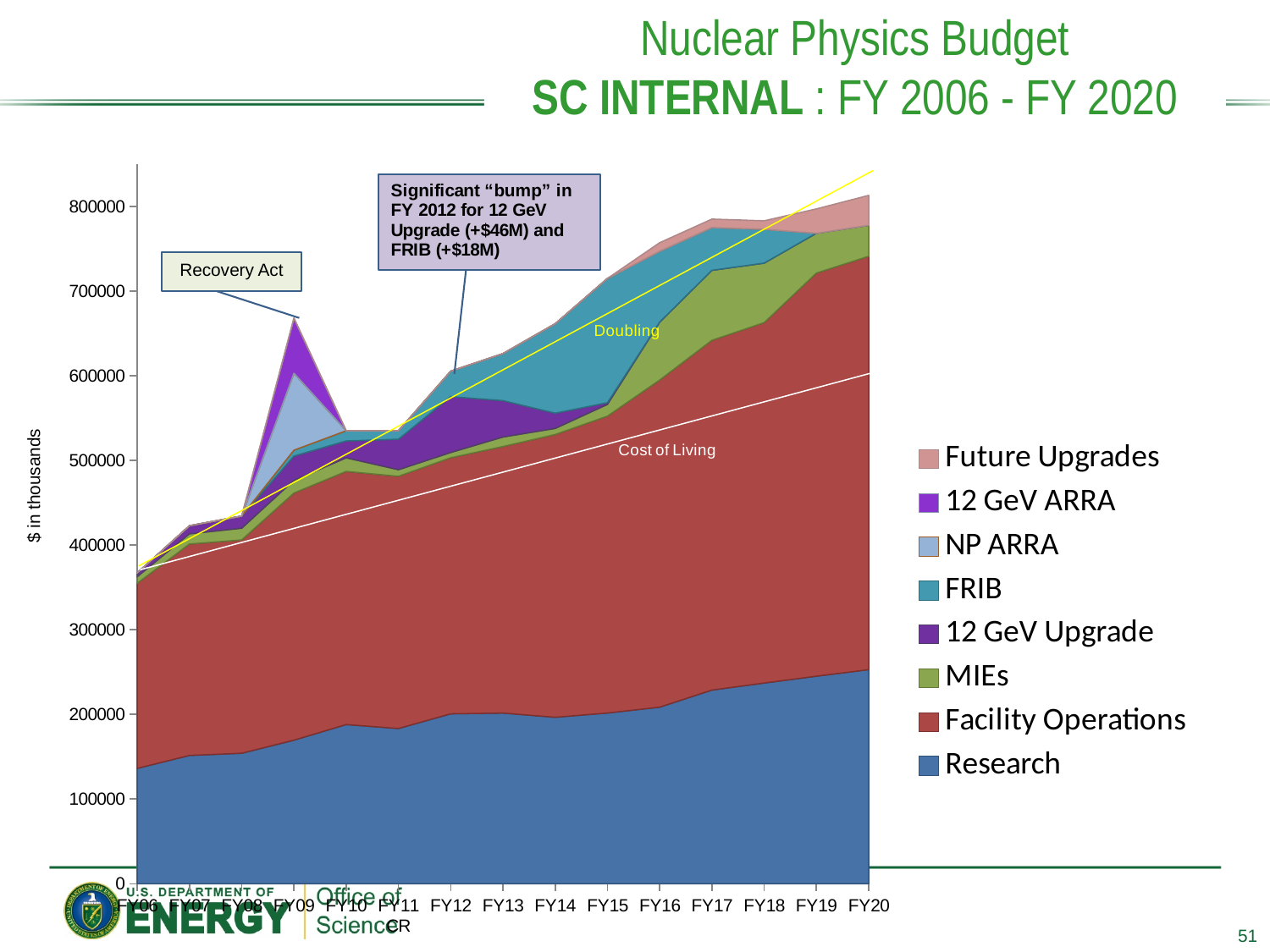
Is the total stacked value in FY06 greater or less than 400000? less Is the total stacked value in FY09 greater or less than 600000? greater What kind of chart is shown on the slide? Stacked area chart Which fiscal year does the 'Recovery Act' annotation point to? FY09 Is the value for Research in FY06 greater or less than 200000? less How many fiscal years are shown along the x axis? 15 What is the label on the y axis? $ in thousands Does the Research series generally rise or fall from FY06 to FY20? rise How many series does the legend list? 8